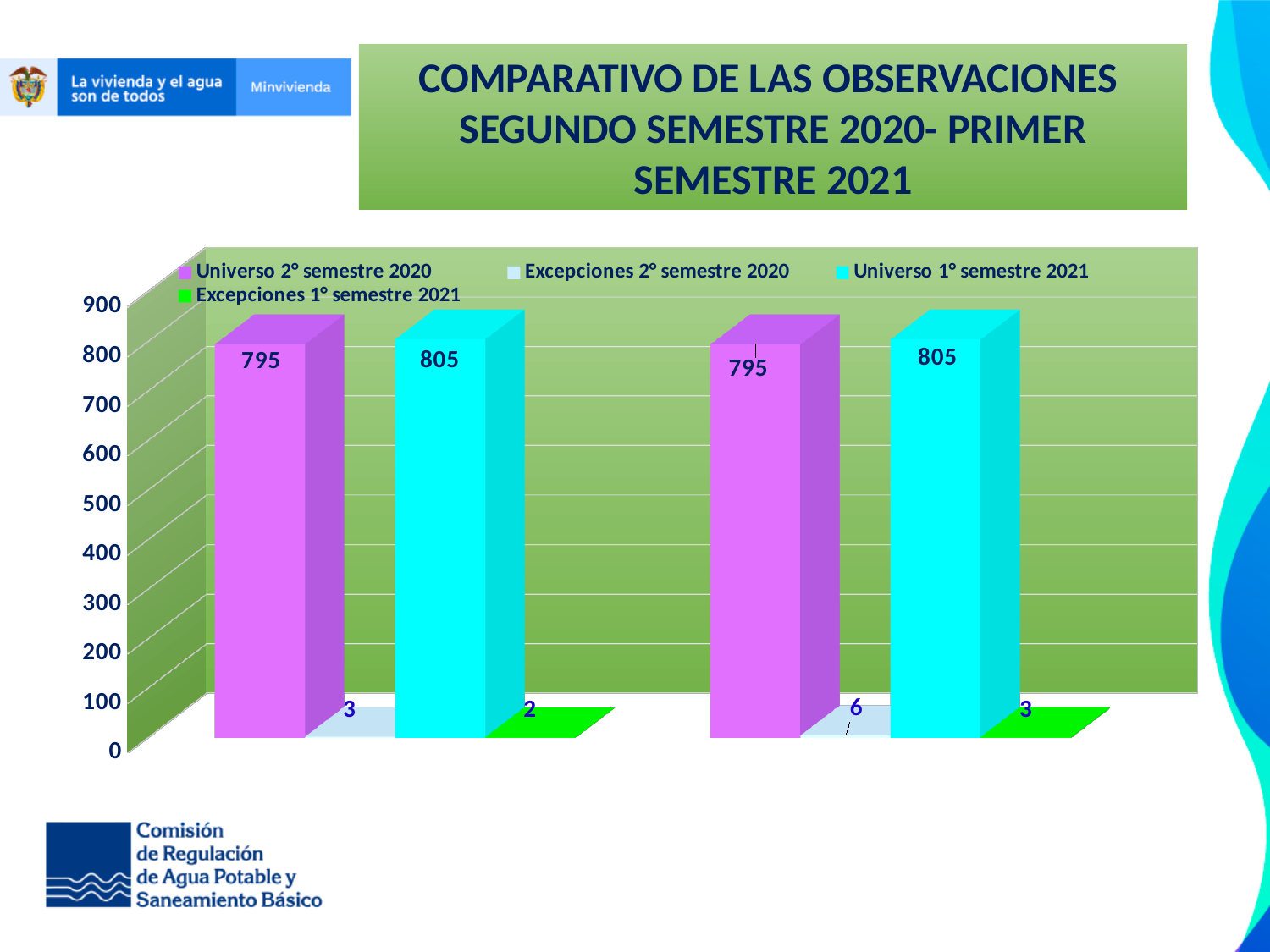
In the left group of bars, what is the value for Excepciones 2° semestre 2020? 3 How many series does the chart legend list? 4 Which series has the lowest value in the left group of bars? Excepciones 1° semestre 2021 In the right group of bars, what is the value for Excepciones 2° semestre 2020? 6 In the right group of bars, what is the value for Excepciones 1° semestre 2021? 3 Is the value for Universo 1° semestre 2021 in the right group greater or less than 700? greater What colour are the bars for Universo 1° semestre 2021? cyan In the left group of bars, what is the difference between Universo 1° semestre 2021 and Universo 2° semestre 2020? 10 What kind of chart is shown on the slide? bar chart In the left group of bars, what is the value for Universo 2° semestre 2020? 795 In the right group of bars, what is the difference between Excepciones 2° semestre 2020 and Excepciones 1° semestre 2021? 3 In the left group of bars, what is the value for Universo 1° semestre 2021? 805